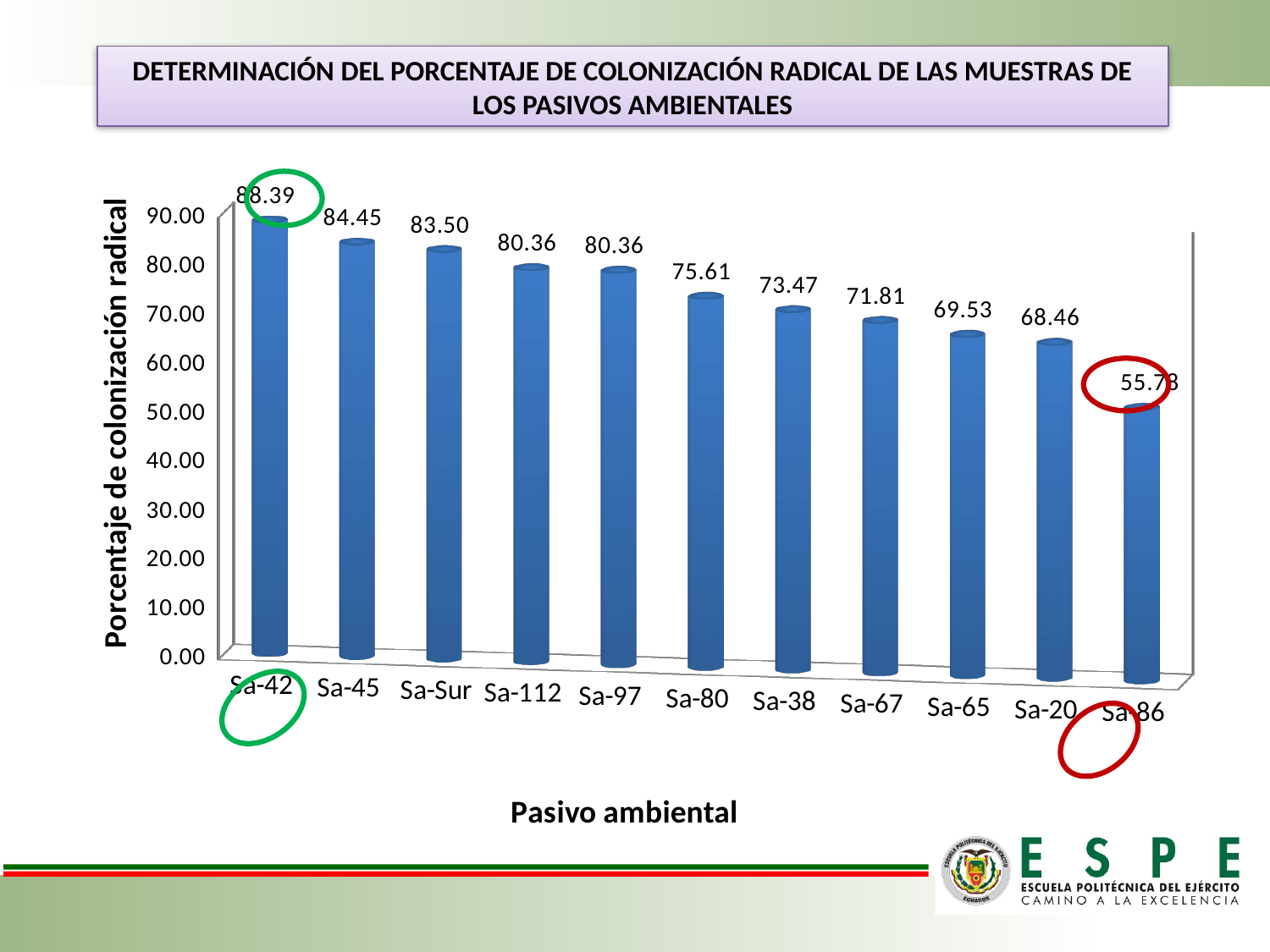
What kind of chart is shown on the slide? bar chart Is the value for Sa-86 greater or less than 60.00? less What is the value for Sa-20? 68.46 What is the label of the x axis? Pasivo ambiental What is the value for Sa-Sur? 83.50 Which is larger, the value for Sa-67 or the value for Sa-65? Sa-67 Which category has the highest value? Sa-42 What is the value for Sa-80? 75.61 Which category has the lowest value? Sa-86 How many categories are shown on the x axis? 11 What is the difference between the values for Sa-45 and Sa-38? 10.98 What is the value for Sa-42? 88.39